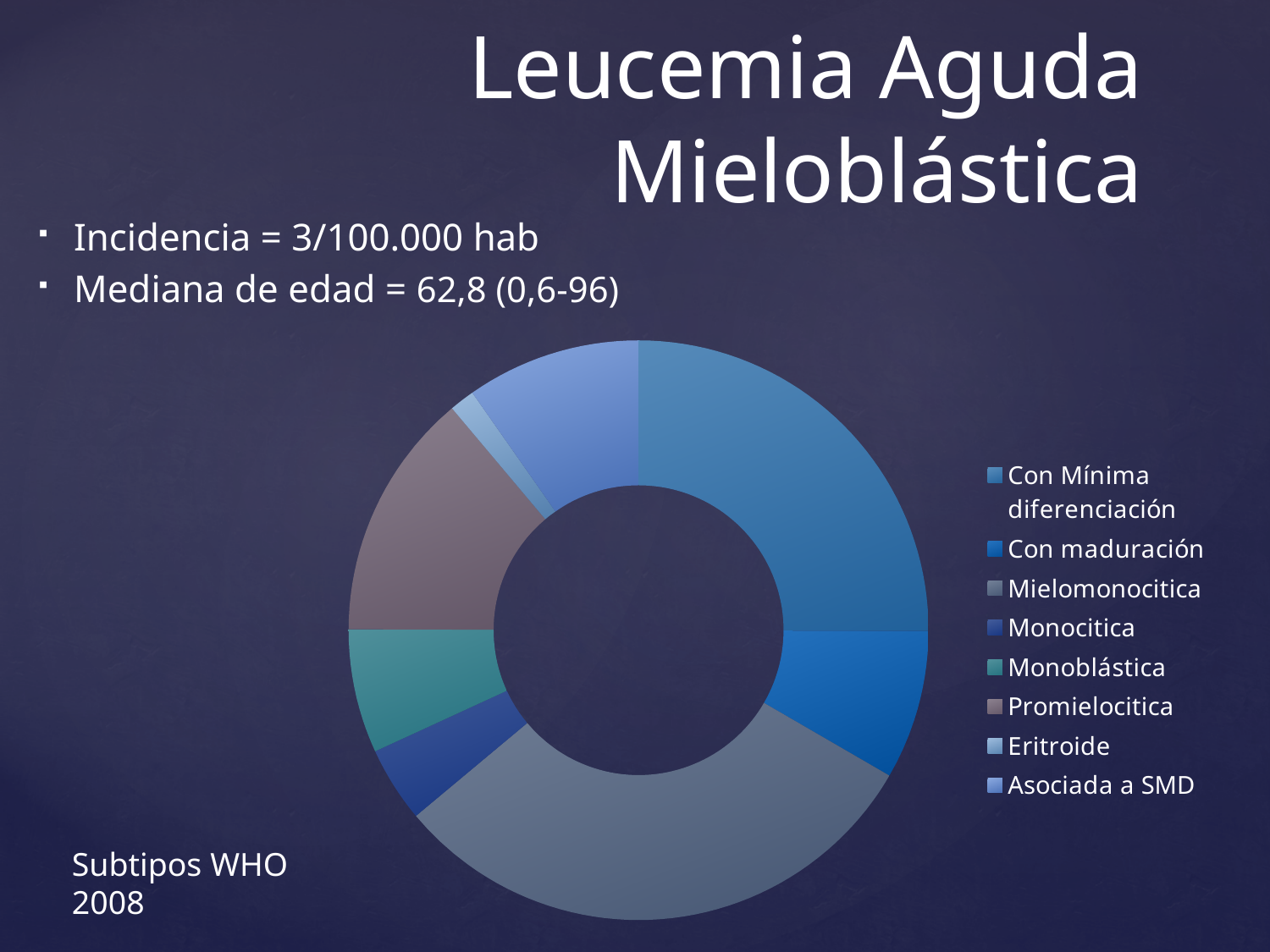
Which slice is larger, Con Mínima diferenciación or Monocitica? Con Mínima diferenciación On which side of the chart is the legend placed? Right How many subtypes (categories) does the chart's legend list? 8 Which subtype has the largest slice in the chart? Mielomonocitica Which subtype has the smallest slice in the chart? Eritroide What kind of chart is shown on the slide? Doughnut (pie) chart Which slice is larger, Con Mínima diferenciación or Con maduración? Con Mínima diferenciación Which slice is larger, Promielocitica or Monocitica? Promielocitica What is the first entry listed in the chart's legend? Con Mínima diferenciación